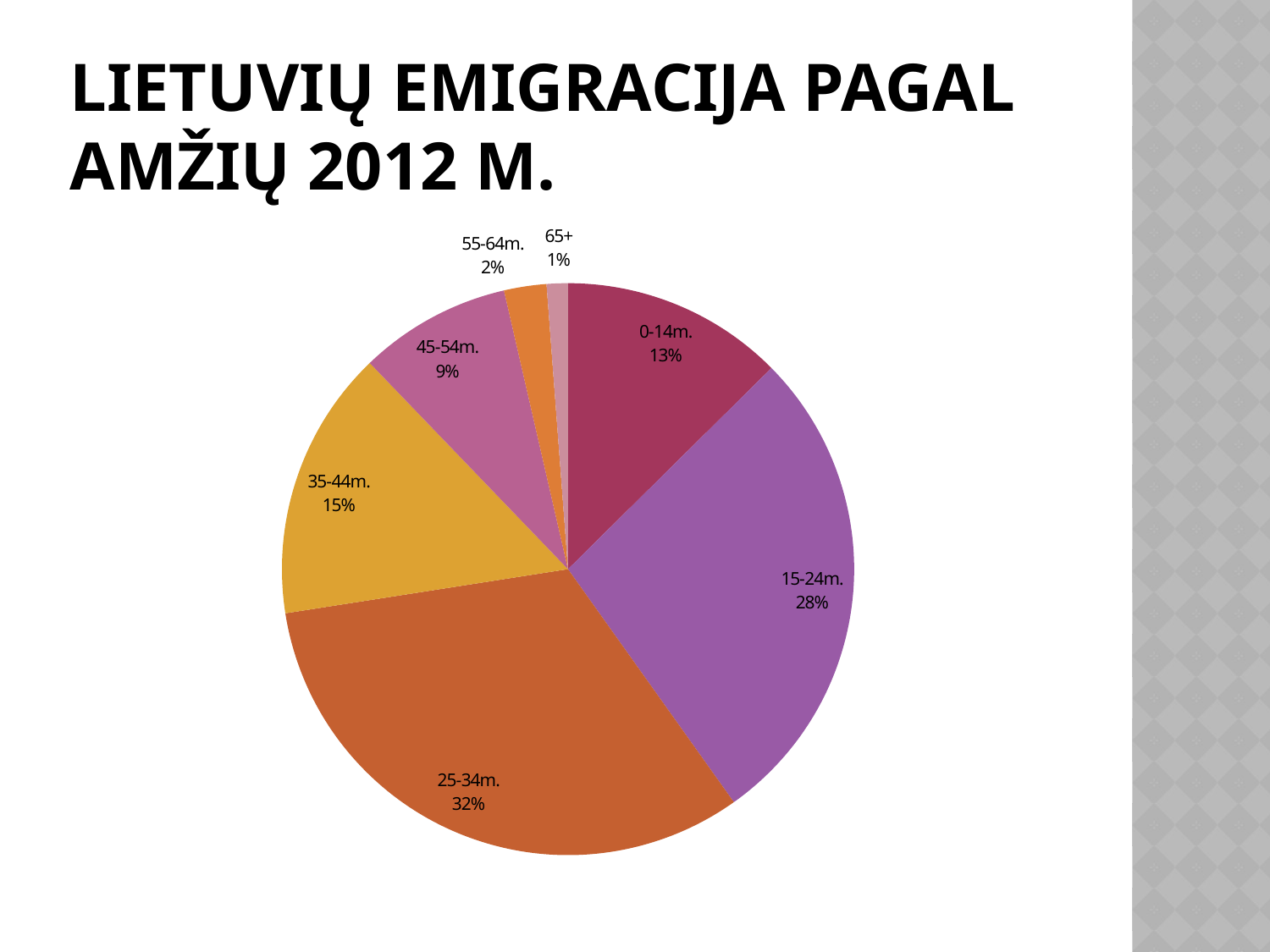
Which age group has the smallest slice of the pie? 65+ How many age categories are shown in the pie chart? 7 Which age group has the largest slice of the pie? 25-34m. Which is larger, the share for 35-44m. or the share for 0-14m.? 35-44m. What is the value shown for the 15-24m. category? 28% What share of the pie does the 25-34m. slice represent? 32% What is the difference between the 35-44m. and 55-64m. shares? 13% What is the value shown for the 45-54m. category? 9% What is the difference between the 25-34m. and 15-24m. shares? 4% What is the value shown for the 0-14m. category? 13% What is the title of the slide? LIETUVIŲ EMIGRACIJA PAGAL AMŽIŲ 2012 M. What kind of chart is shown on the slide? Pie chart